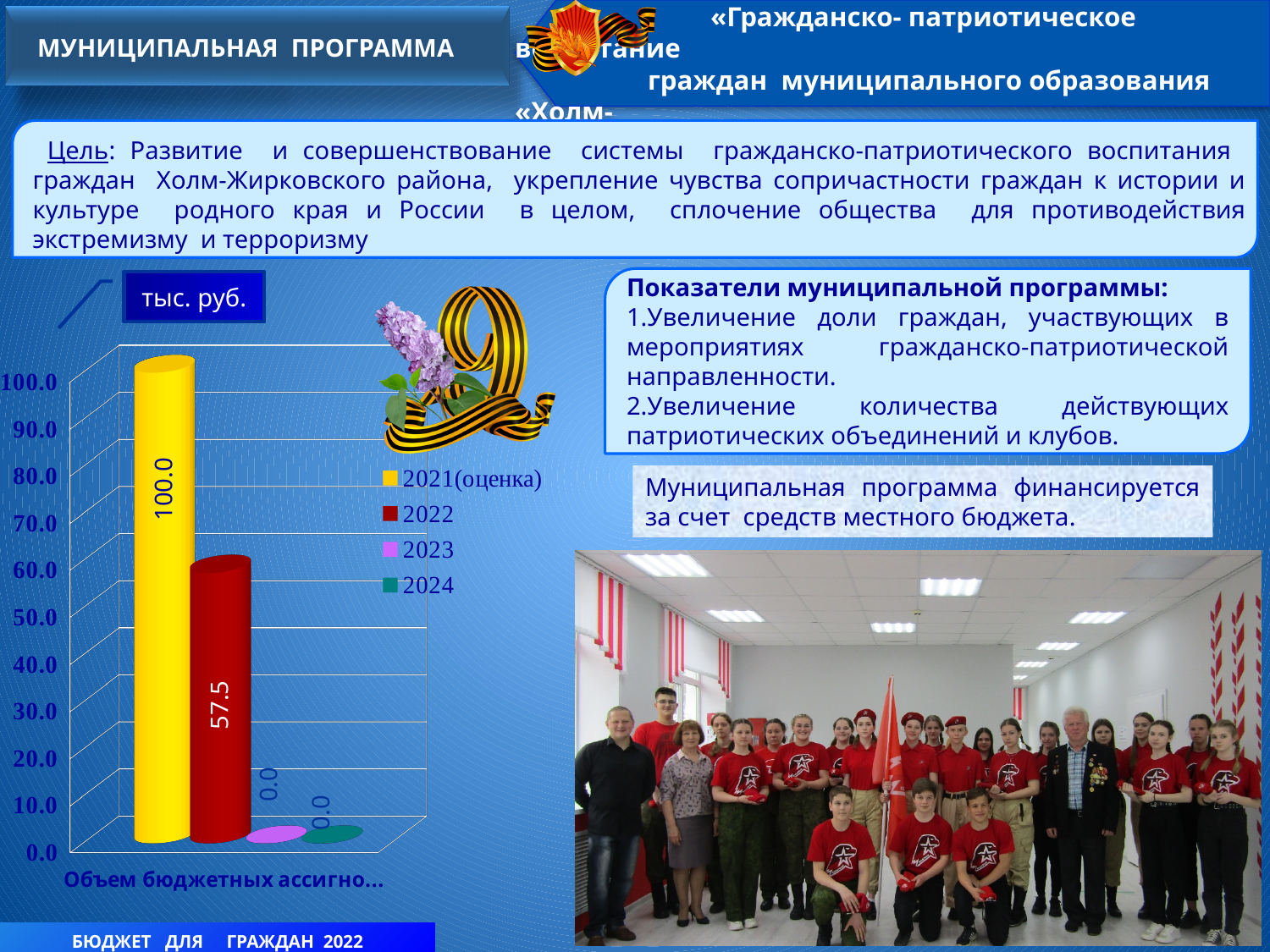
What kind of chart is shown on the slide? bar chart Which is larger, the value for 2021(оценка) or the value for 2022? 2021(оценка) What colour is the bar for 2022? red Which year has the highest value on the chart? 2021(оценка) What is the value for 2024 on the chart? 0.0 Is the value for 2022 greater or less than 50.0? greater What is the value for 2022 on the chart? 57.5 What is the value for 2023 on the chart? 0.0 What unit is shown in the box above the chart? тыс. руб. What is the value for 2021(оценка) on the chart? 100.0 How many series does the legend list? 4 What is the difference between the values for 2021(оценка) and 2022? 42.5